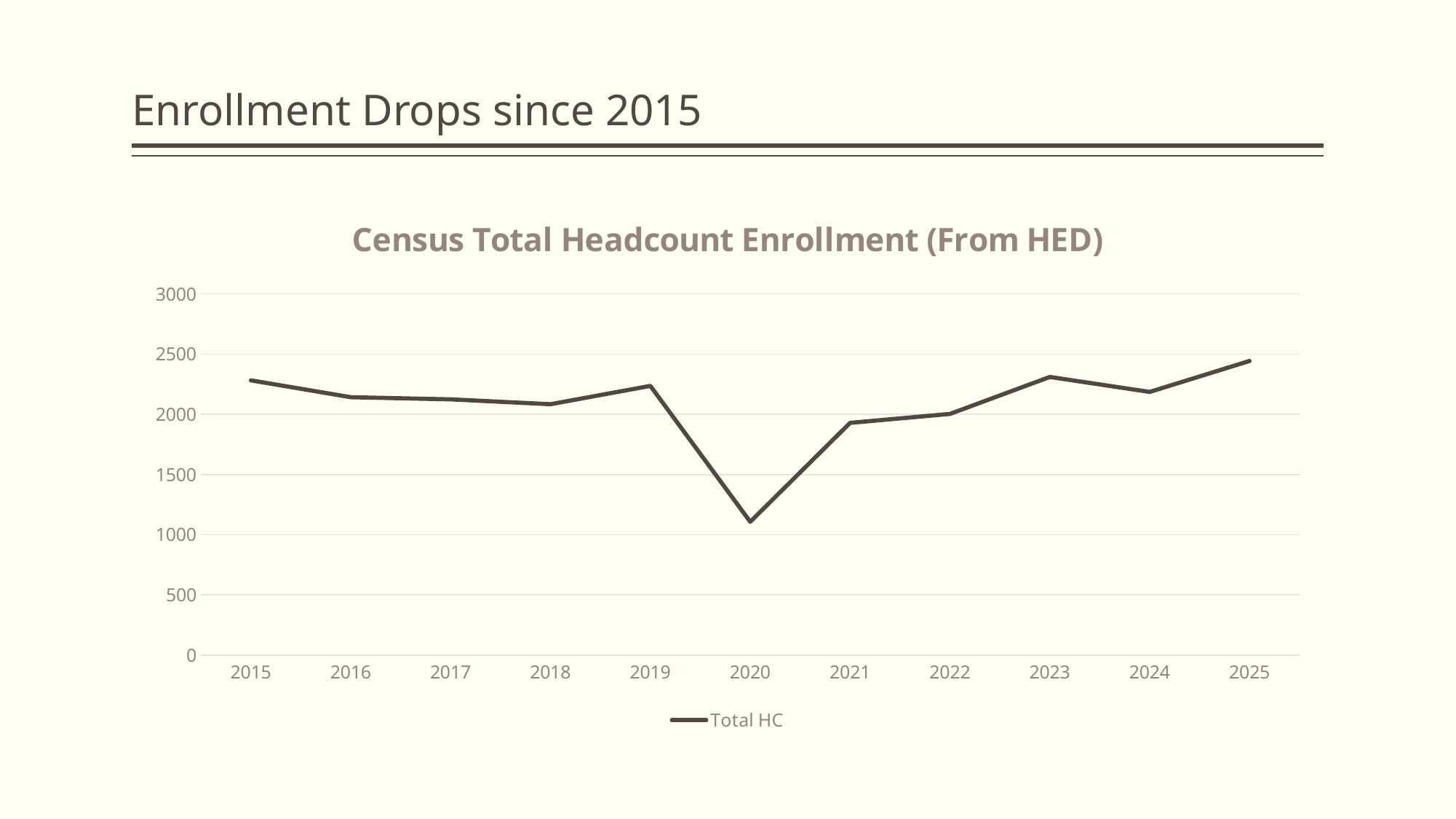
Is the value for 2023 greater or less than 2000? greater How many series does the legend list? 1 What is the name of the series shown in the legend? Total HC What is the title of the chart? Census Total Headcount Enrollment (From HED) Is the value for 2025 greater or less than 2500? less Is the value for 2020 greater or less than 1500? less Which year has the highest Total HC value? 2025 What kind of chart is shown on the slide? line chart Do the Total HC values rise or fall from 2020 to 2023? rise Which year has the lowest Total HC value? 2020 How many years are plotted along the x axis? 11 Which year has the larger Total HC value, 2019 or 2018? 2019